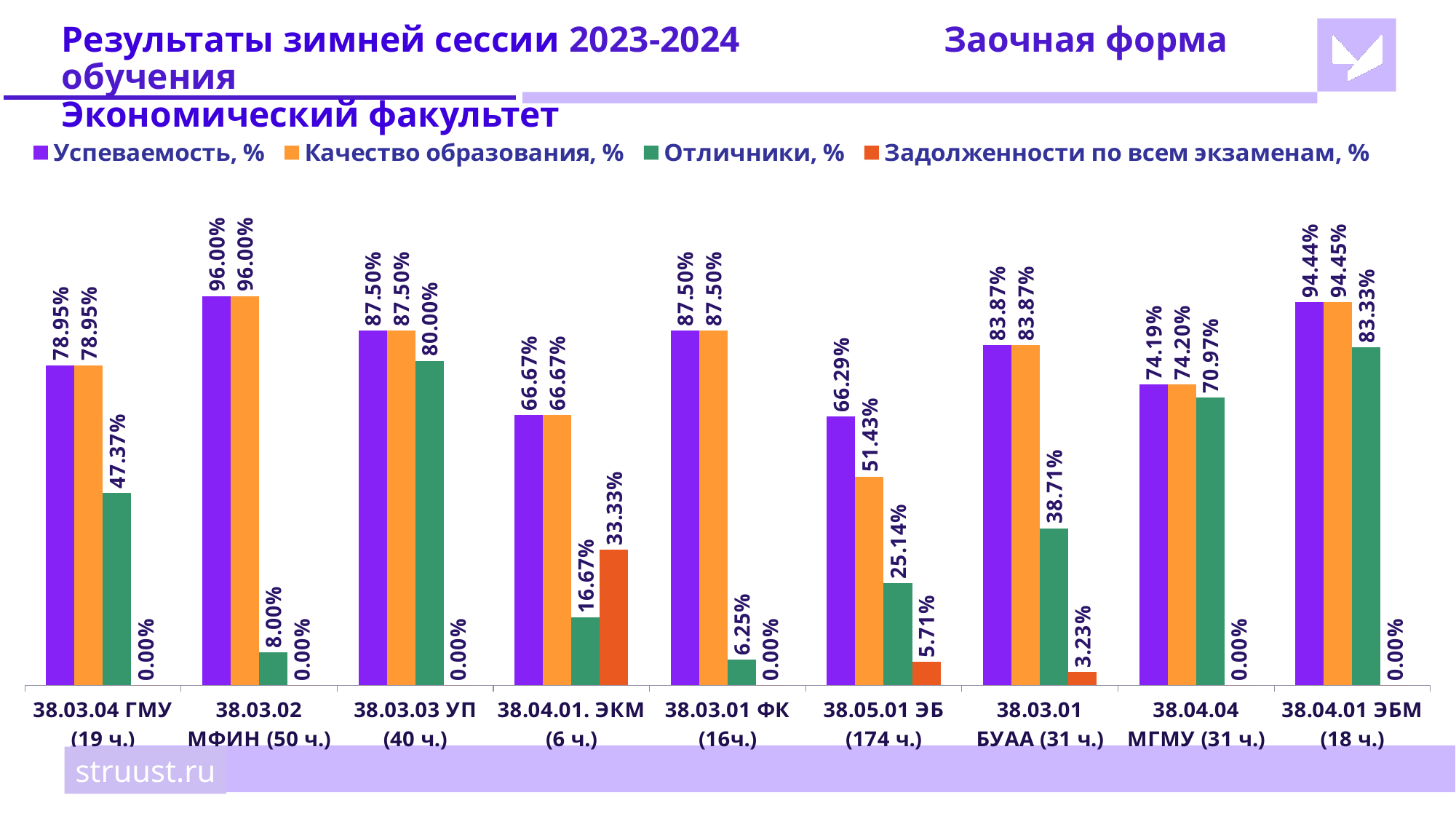
How many categories are shown on the x axis? 9 What is the value of Успеваемость, % for 38.05.01 ЭБ (174 ч.)? 66.29% What colour represents Отличники, % in the legend? green Which is larger: Отличники, % for 38.03.04 ГМУ (19 ч.) or for 38.03.01 БУАА (31 ч.)? 38.03.04 ГМУ (19 ч.) Which category has the lowest Отличники, %? 38.03.01 ФК (16ч.) Which category has the highest Задолженности по всем экзаменам, %? 38.04.01. ЭКМ (6 ч.) How many series does the legend list? 4 What is the difference between Качество образования, % and Отличники, % for 38.03.02 МФИН (50 ч.)? 88.00% What is the value of Отличники, % for 38.03.03 УП (40 ч.)? 80.00% Which category has the highest Успеваемость, %? 38.03.02 МФИН (50 ч.) What kind of chart is shown on the slide? bar chart What is the value of Задолженности по всем экзаменам, % for 38.04.01. ЭКМ (6 ч.)? 33.33%